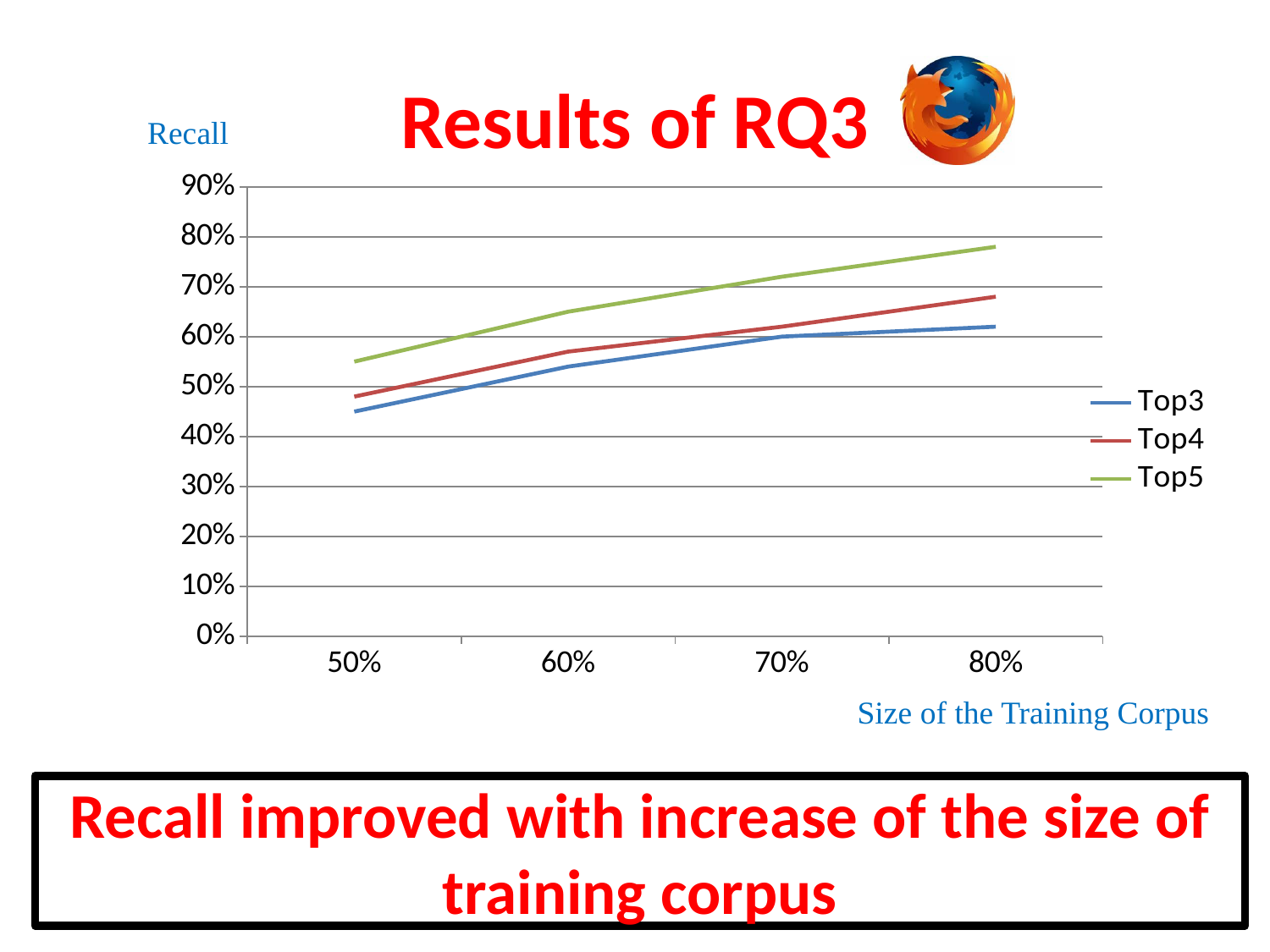
Is the recall for Top3 at a training corpus size of 80% greater or less than 70%? less Is the recall for Top4 at a training corpus size of 80% greater or less than 60%? greater How many series does the legend list? 3 Which series has the highest recall at a training corpus size of 80%? Top5 Is the recall for Top5 at a training corpus size of 80% greater or less than 70%? greater Does the recall for Top4 rise or fall as the size of the training corpus increases from 50% to 80%? rise At a training corpus size of 70%, which series has the higher recall, Top5 or Top3? Top5 What kind of chart is shown on the slide? line chart Which series has the lowest recall at a training corpus size of 50%? Top3 How many training corpus sizes are plotted along the x axis? 4 What is the label of the x axis? Size of the Training Corpus